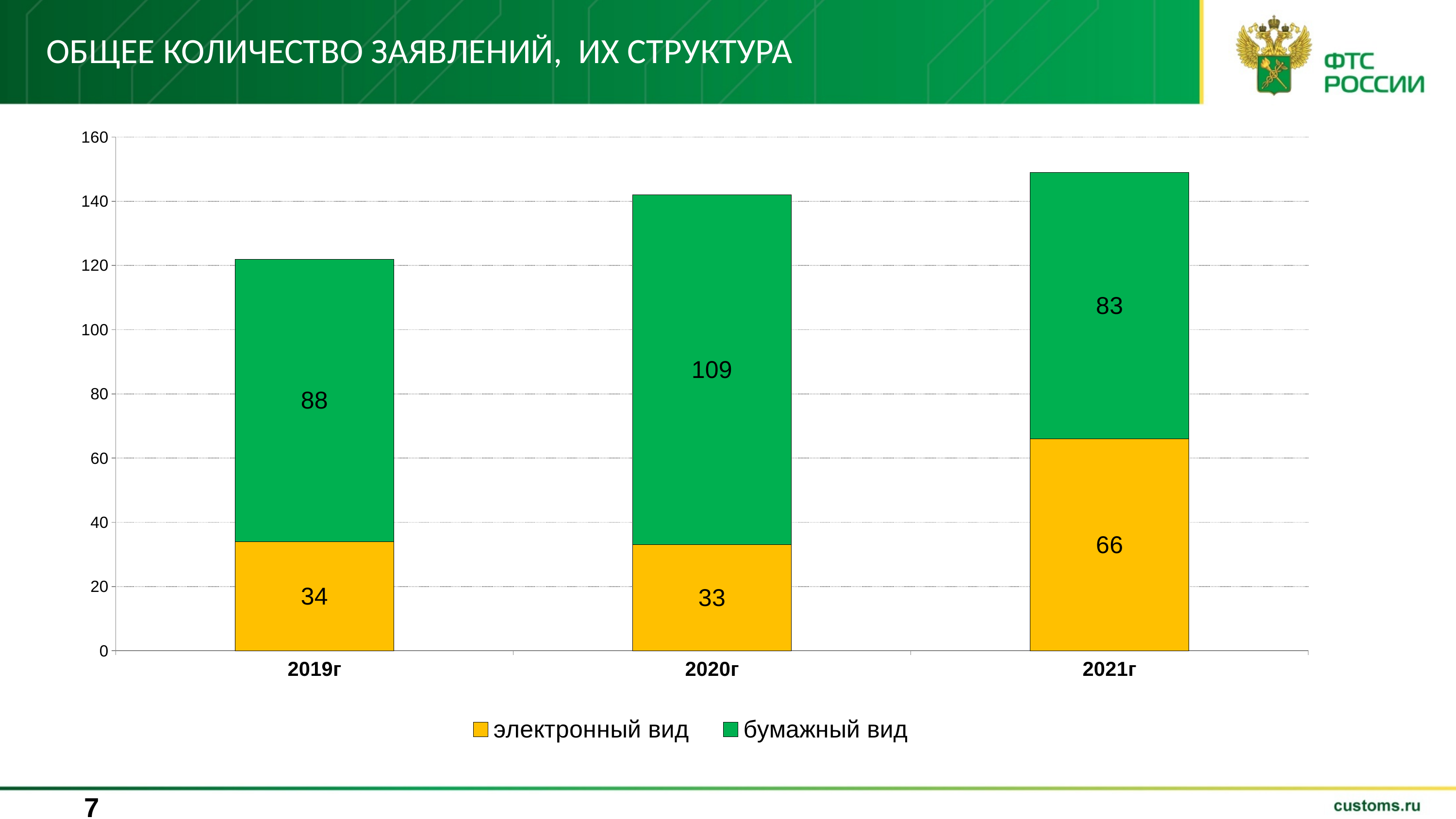
Which year has the lowest value for электронный вид? 2020г How many years are shown on the x axis? 3 What is the total of the stacked bar for 2019г? 122 What is the total of the stacked bar for 2021г? 149 How many series does the legend list? 2 What kind of chart is shown on the slide? stacked bar chart What is the value for электронный вид in 2021г? 66 Which is larger: электронный вид in 2021г or бумажный вид in 2021г? бумажный вид in 2021г What is the value for электронный вид in 2019г? 34 What is the difference between бумажный вид in 2020г and бумажный вид in 2019г? 21 What is the value for бумажный вид in 2020г? 109 Which year has the highest value for бумажный вид? 2020г